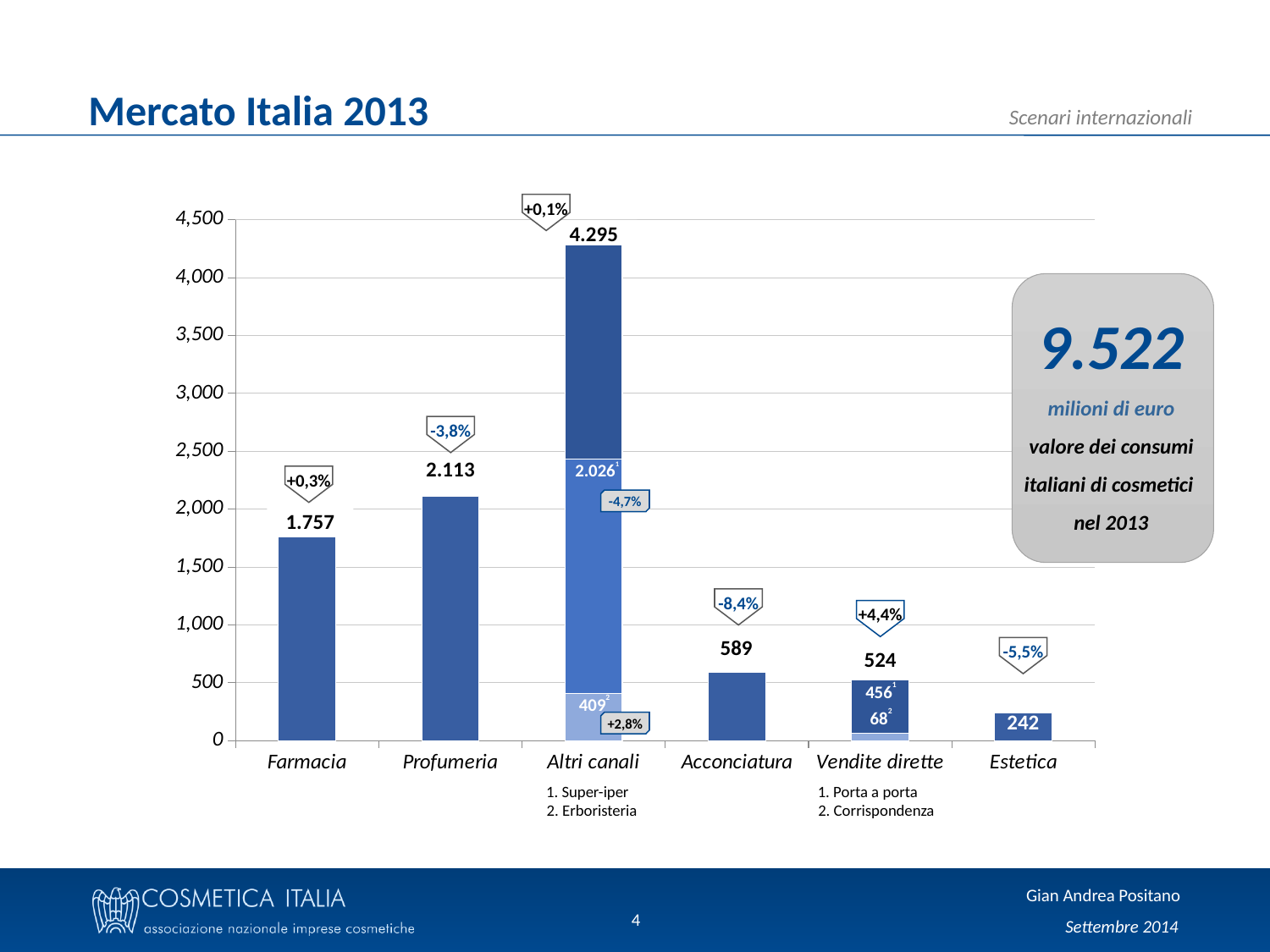
What kind of chart is shown on the slide? Bar chart What is the difference between the values for Profumeria and Farmacia? 356 Which is larger, the value for Acconciatura or the value for Vendite dirette? Acconciatura Which category has the highest value? Altri canali Which category has the lowest value? Estetica How many categories are shown on the x axis? 6 What is the value for Profumeria? 2.113 What is the total value shown for Altri canali? 4.295 What is the value of the Porta a porta segment within Vendite dirette? 456 What percentage change is shown above the Acconciatura bar? -8,4% What is the value for Farmacia? 1.757 What is the value for Acconciatura? 589